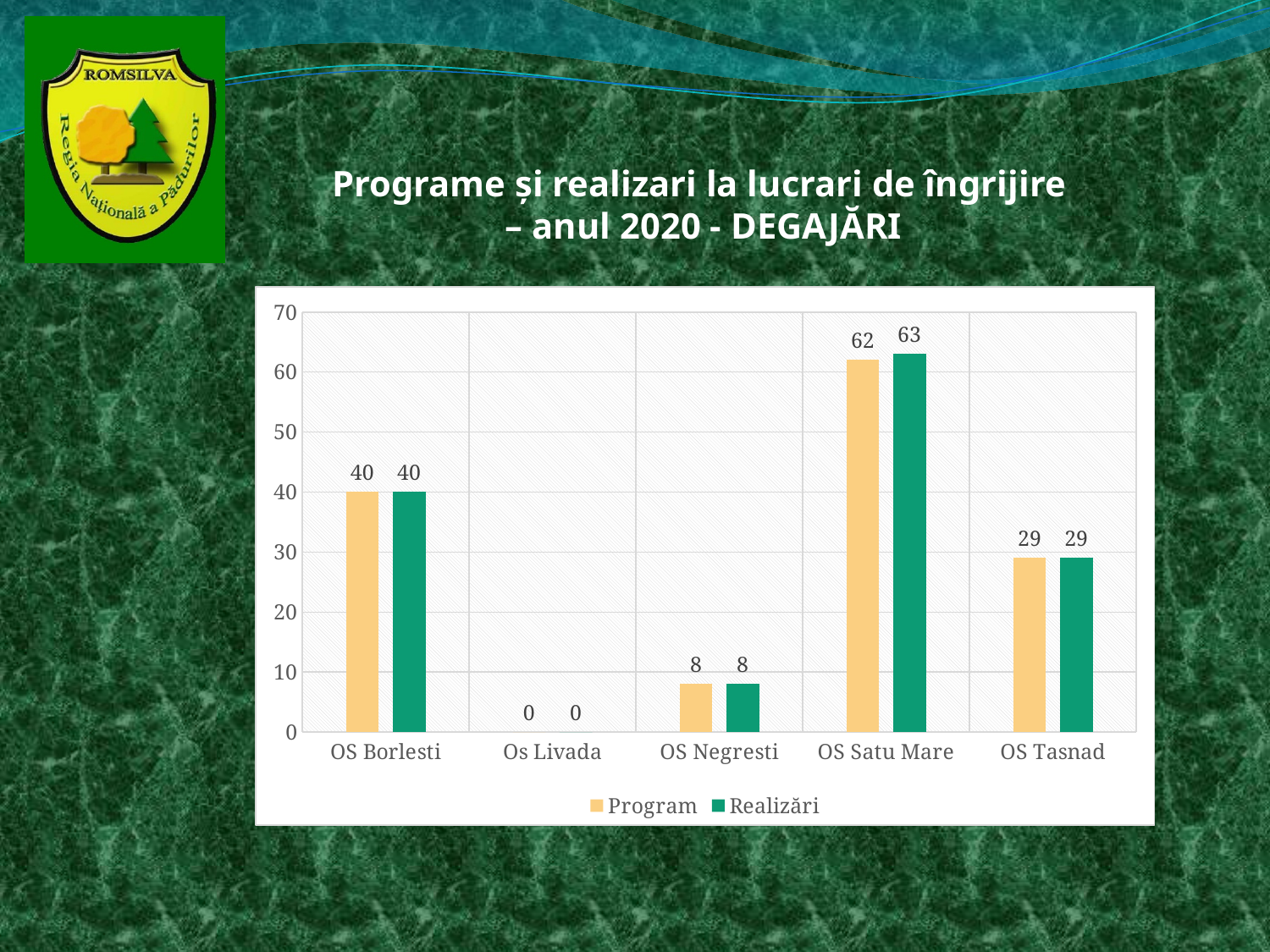
What is the Program value for OS Satu Mare? 62 What is the Program value for OS Tasnad? 29 Which category has the lowest Program value? Os Livada Which is larger, the Program value for OS Borlesti or the Program value for OS Tasnad? OS Borlesti What is the Realizări value for OS Satu Mare? 63 How many categories are shown on the x axis? 5 What is the difference between the Program values for OS Borlesti and OS Tasnad? 11 How many series does the legend list? 2 Which category has the highest Realizări value? OS Satu Mare What is the difference between the Realizări and Program values for OS Satu Mare? 1 What is the Realizări value for OS Negresti? 8 What kind of chart is shown on the slide? Bar chart